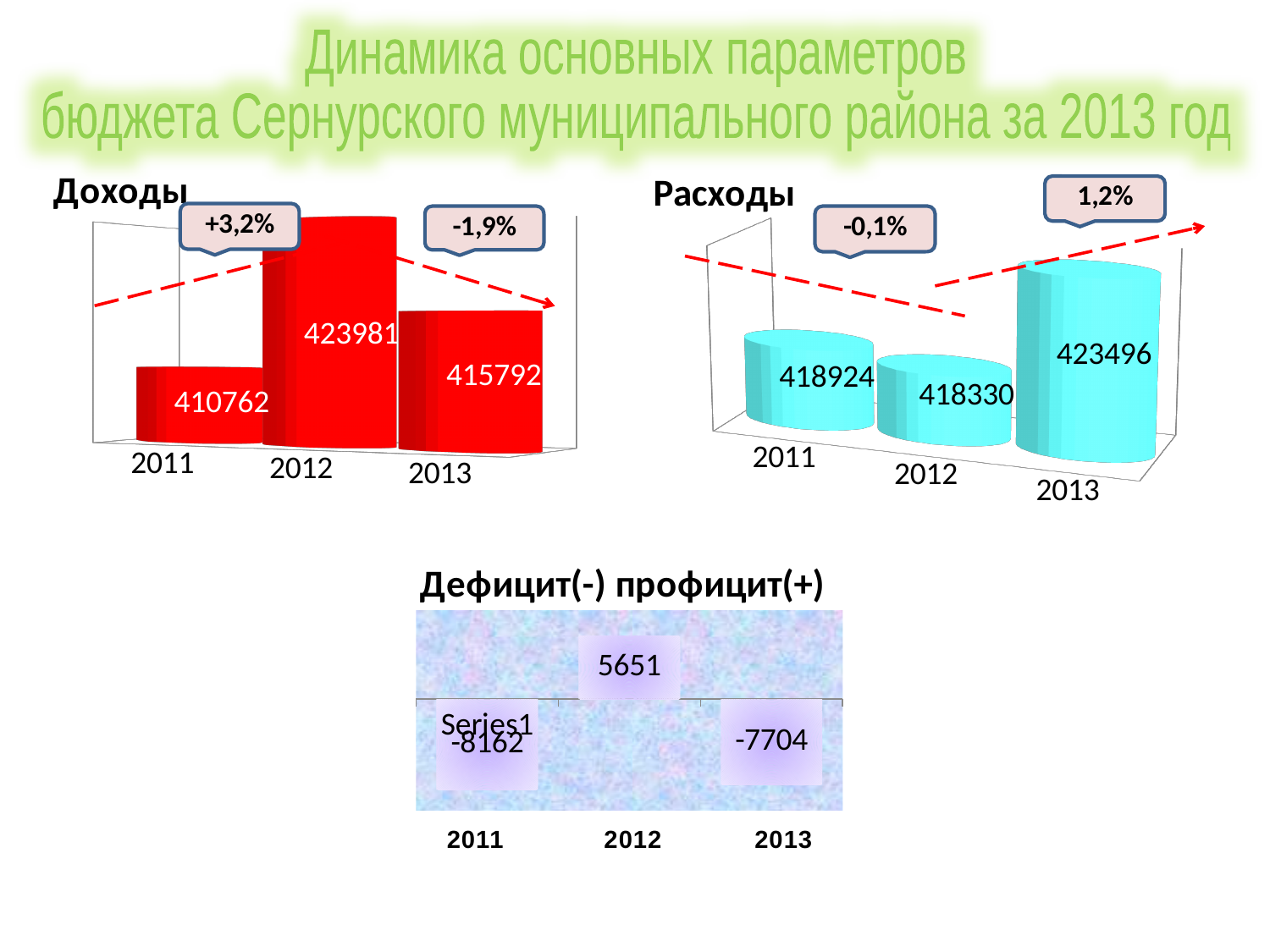
In the Дефицит(-) профицит(+) chart, what is the value for 2011? -8162 In the Расходы chart, what is the value for 2013? 423496 In the Доходы chart, what is the difference between the 2012 and 2013 values? 8189 In the Расходы chart, what is the difference between the 2011 and 2012 values? 594 What percentage change label is shown above the 2013 bar in the Расходы chart? 1,2% How many years are shown in the Доходы chart? 3 In the Доходы chart, which year has the lowest value? 2011 In the Расходы chart, which year has the highest value? 2013 In the Расходы chart, which is larger: the value for 2011 or the value for 2012? 2011 In the Дефицит(-) профицит(+) chart, which year has the highest value? 2012 What kind of chart is the Доходы chart? bar chart In the Доходы chart, what is the value for 2012? 423981